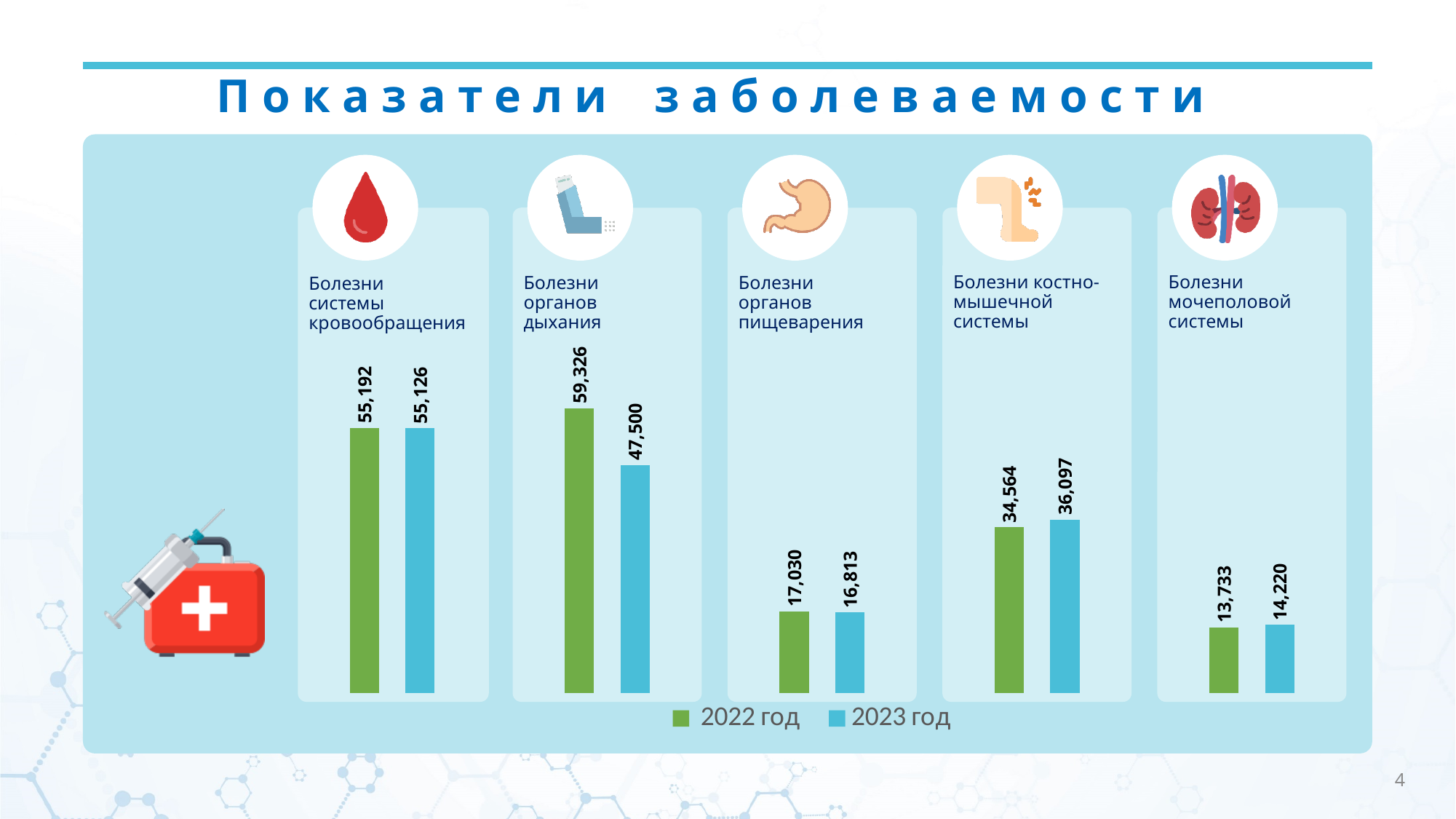
What is the value for Болезни органов дыхания in 2022 год? 59,326 Which category has the highest value for 2022 год? Болезни органов дыхания What type of chart is shown on the slide? Bar chart What is the difference between the 2022 год and 2023 год values for Болезни органов дыхания? 11,826 What is the value for Болезни мочеполовой системы in 2023 год? 14,220 What is the value for Болезни органов пищеварения in 2023 год? 16,813 What is the difference between the 2023 год and 2022 год values for Болезни костно-мышечной системы? 1,533 How many disease categories are shown in the chart? 5 Which is larger for Болезни органов дыхания: the 2022 год value or the 2023 год value? 2022 год How many series does the legend list? 2 Which category has the lowest value for 2023 год? Болезни мочеполовой системы What is the value for Болезни костно-мышечной системы in 2022 год? 34,564